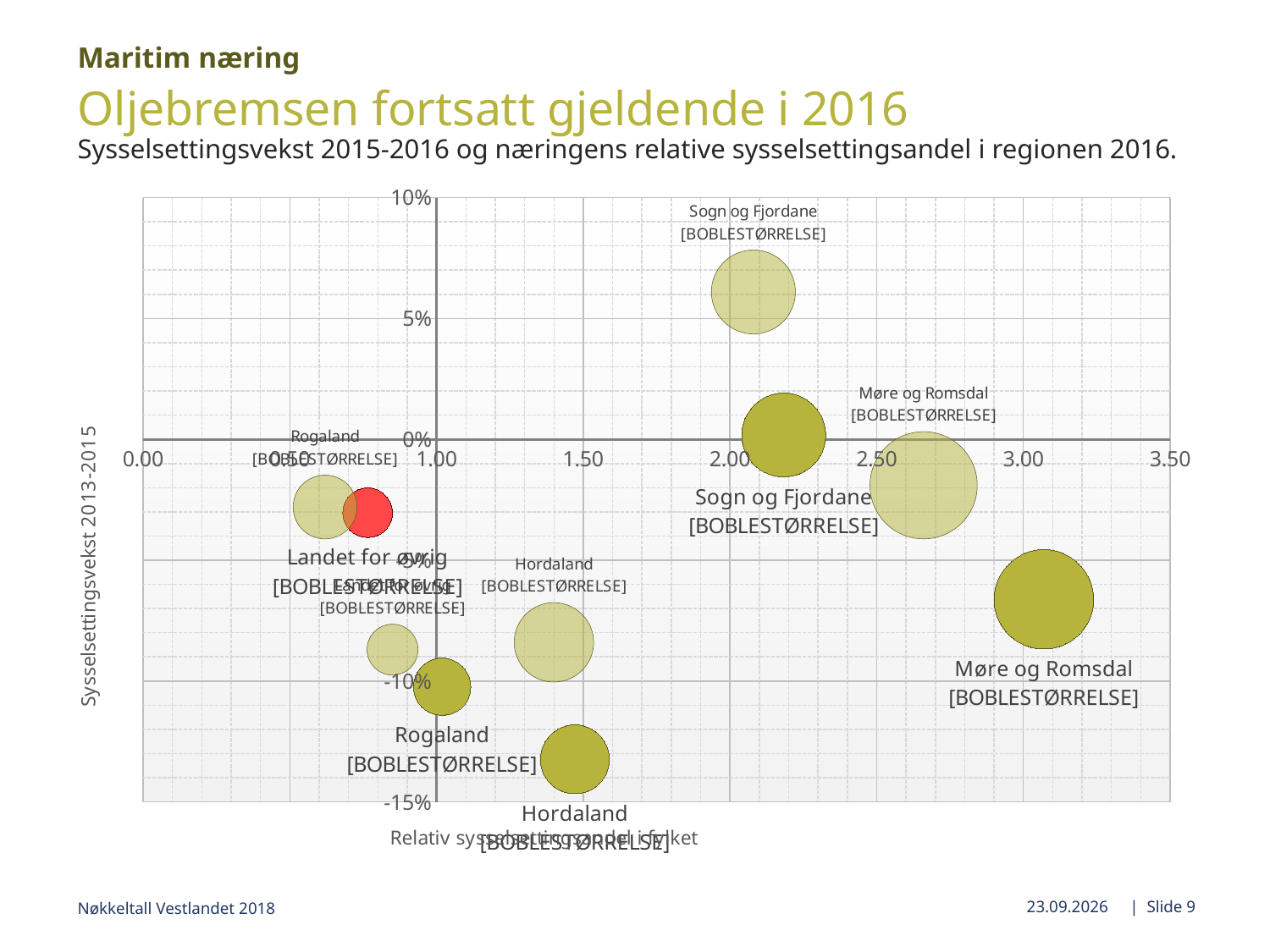
Is the relative employment share (x value) for the large Møre og Romsdal bubble at the bottom right greater or less than 3.00? greater Which region's bubble sits highest on the y axis (highest employment growth)? Sogn og Fjordane What is the title of the chart's y axis? Sysselsettingsvekst 2013-2015 Is the employment growth for the large Møre og Romsdal bubble at the bottom right greater or less than -5%? less Which bubble is further to the right on the x axis: the large Møre og Romsdal bubble or the lowest Hordaland bubble? Møre og Romsdal Is the employment growth for the lowest Hordaland bubble greater or less than -10%? less Which region's bubble sits lowest on the y axis (lowest employment growth)? Hordaland What is the highest value shown on the y axis? 10% What is the highest value shown on the x axis? 3.50 What kind of chart is shown on the slide? Bubble chart